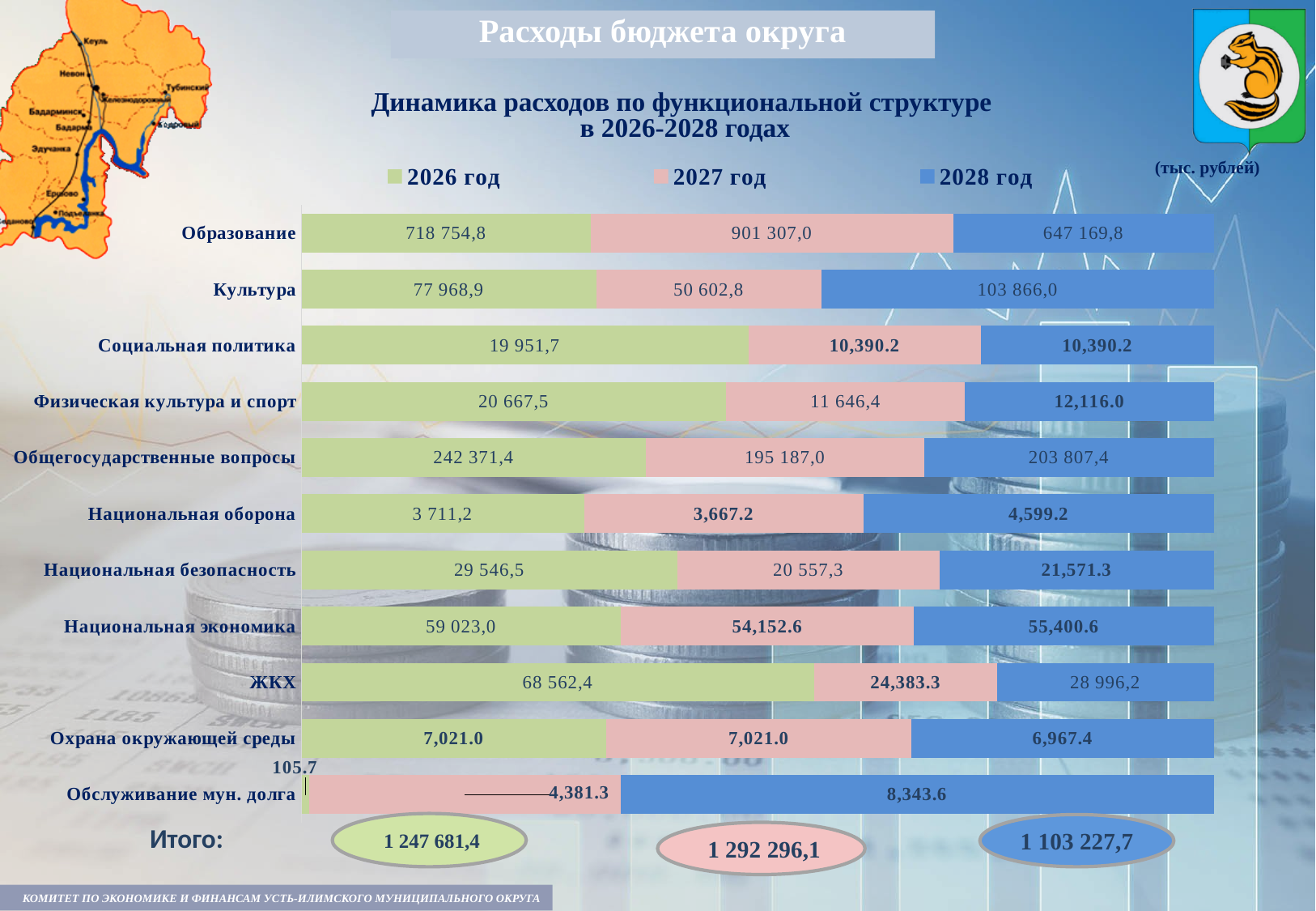
How many series does the legend list? 3 What is the value for Обслуживание мун. долга in 2026 год? 105.7 What is the difference between the 2028 год and 2026 год values for Культура? 25 897,1 For ЖКХ, which is larger: the 2026 год value or the 2027 год value? 2026 год Which category has the highest value in 2027 год? Образование What is the value for Национальная экономика in 2027 год? 54,152.6 How many categories are shown in the chart? 11 Which category has the lowest value in 2026 год? Обслуживание мун. долга What kind of chart is shown on the slide? Stacked bar chart Does the value for Обслуживание мун. долга rise or fall from 2026 год to 2028 год? Rises What is the value for Образование in 2026 год? 718 754,8 What is the value for Культура in 2028 год? 103 866,0